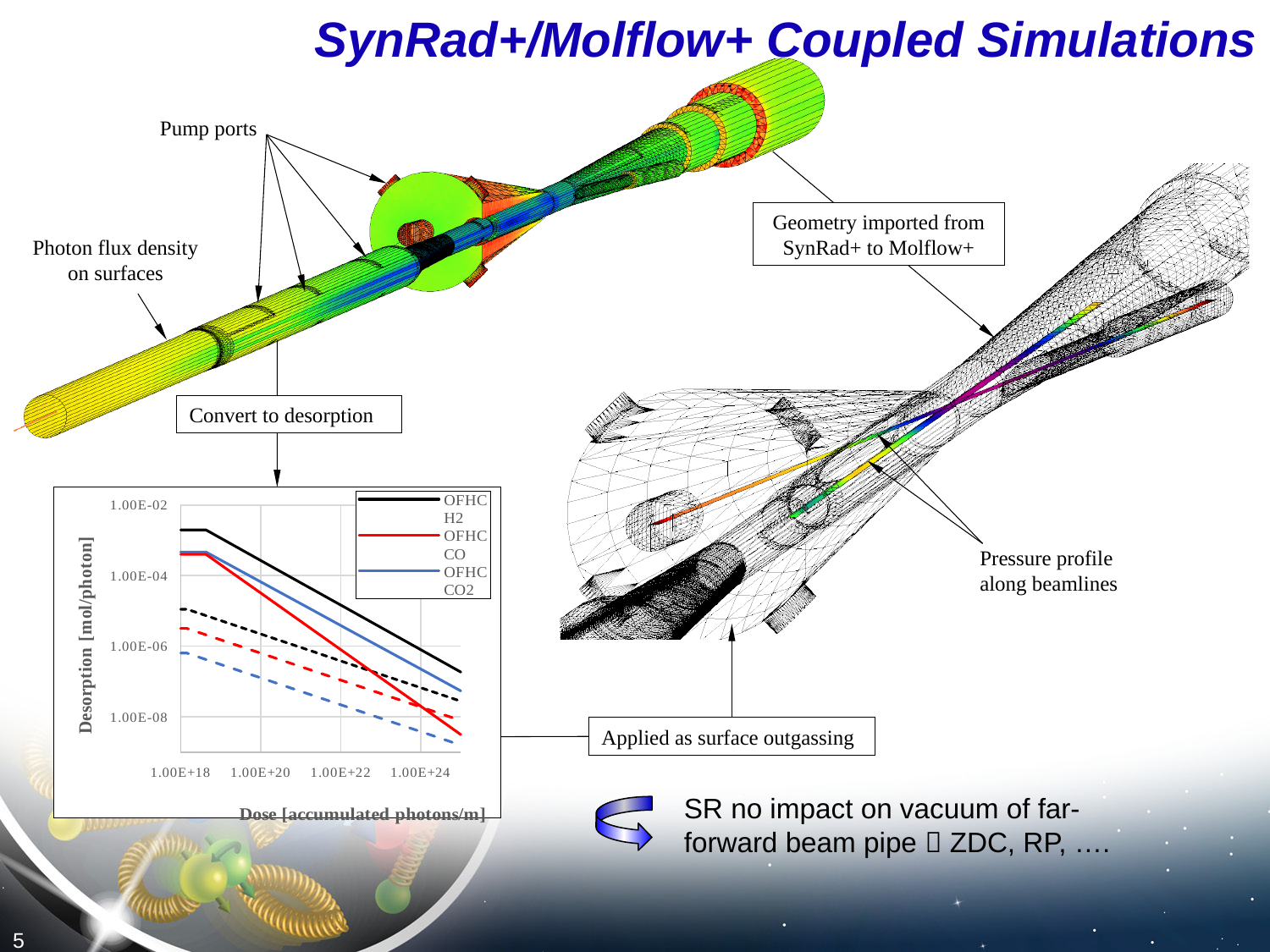
What is the label of the x-axis of the chart? Dose [accumulated photons/m] How many tick labels are shown on the x axis of the chart? 4 What is the label of the y-axis of the chart? Desorption [mol/photon] How many series does the chart legend list? 3 Do the desorption values rise or fall as the dose increases along the x axis? fall What kind of chart is shown on the slide? line chart At a dose of 1.00E+18, is the solid OFHC CO line greater or less than 1.00E-04? greater Which legend series has the highest desorption at a dose of 1.00E+18? OFHC H2 At a dose of 1.00E+18, which is larger: the solid OFHC H2 line or the solid OFHC CO2 line? OFHC H2 Among the solid lines, which series is lowest at a dose of 1.00E+24? OFHC CO At a dose of 1.00E+24, is the solid OFHC H2 line greater or less than 1.00E-08? greater At a dose of 1.00E+18, is the solid OFHC H2 line greater or less than 1.00E-04? greater